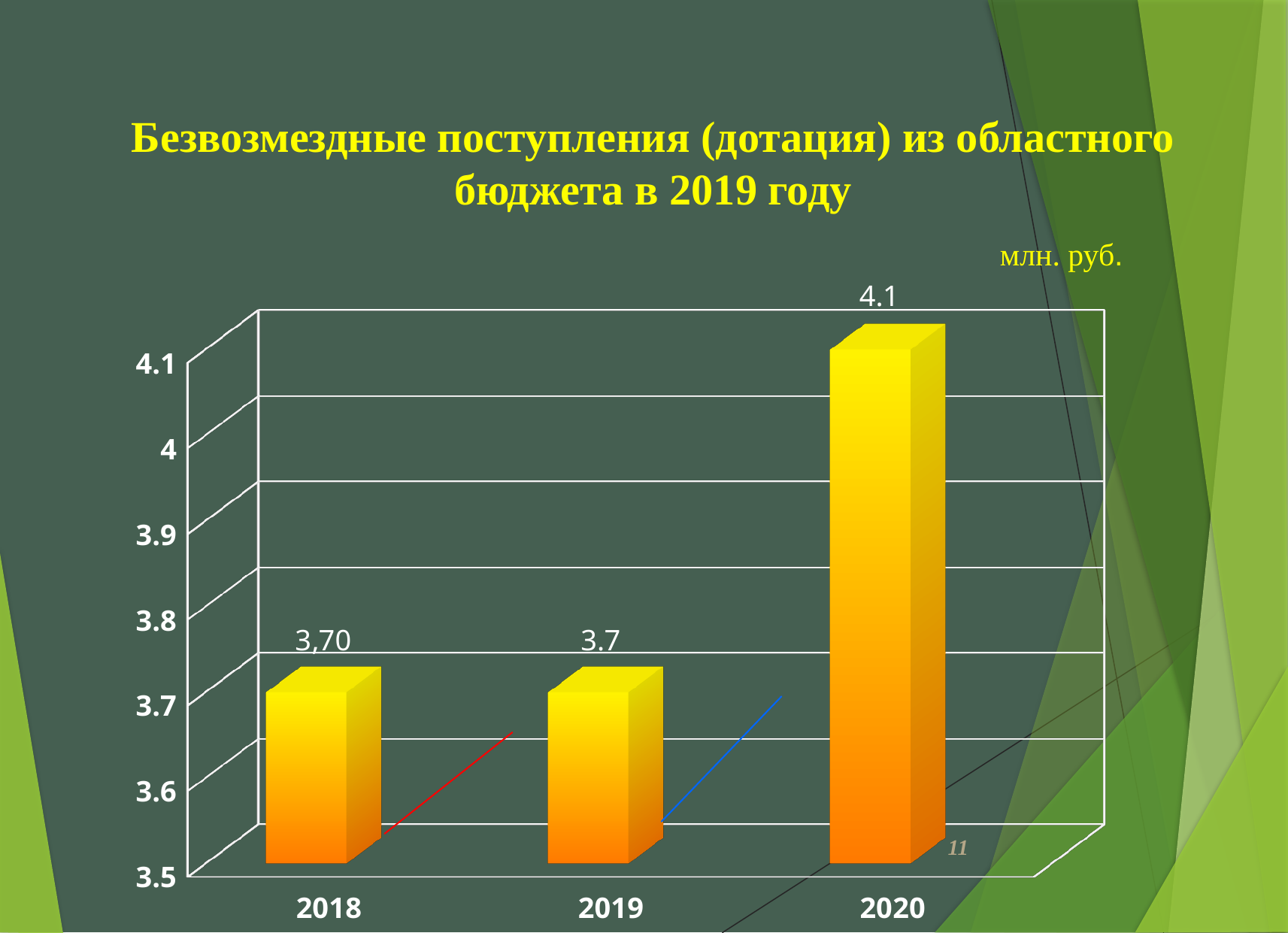
Which year has the highest value? 2020 Do the values rise or fall from 2019 to 2020? rise Is the value for 2019 greater or less than 3.8? less Is the value for 2020 greater or less than 4? greater What is the value shown for 2020? 4.1 What unit of measurement is indicated above the chart? млн. руб. Which is larger, the value for 2020 or the value for 2018? 2020 What is the value shown for 2019? 3.7 How many years are shown on the x axis? 3 What is the difference between the values for 2020 and 2019? 0.4 What kind of chart is shown on the slide? bar chart What is the value shown for 2018? 3,70